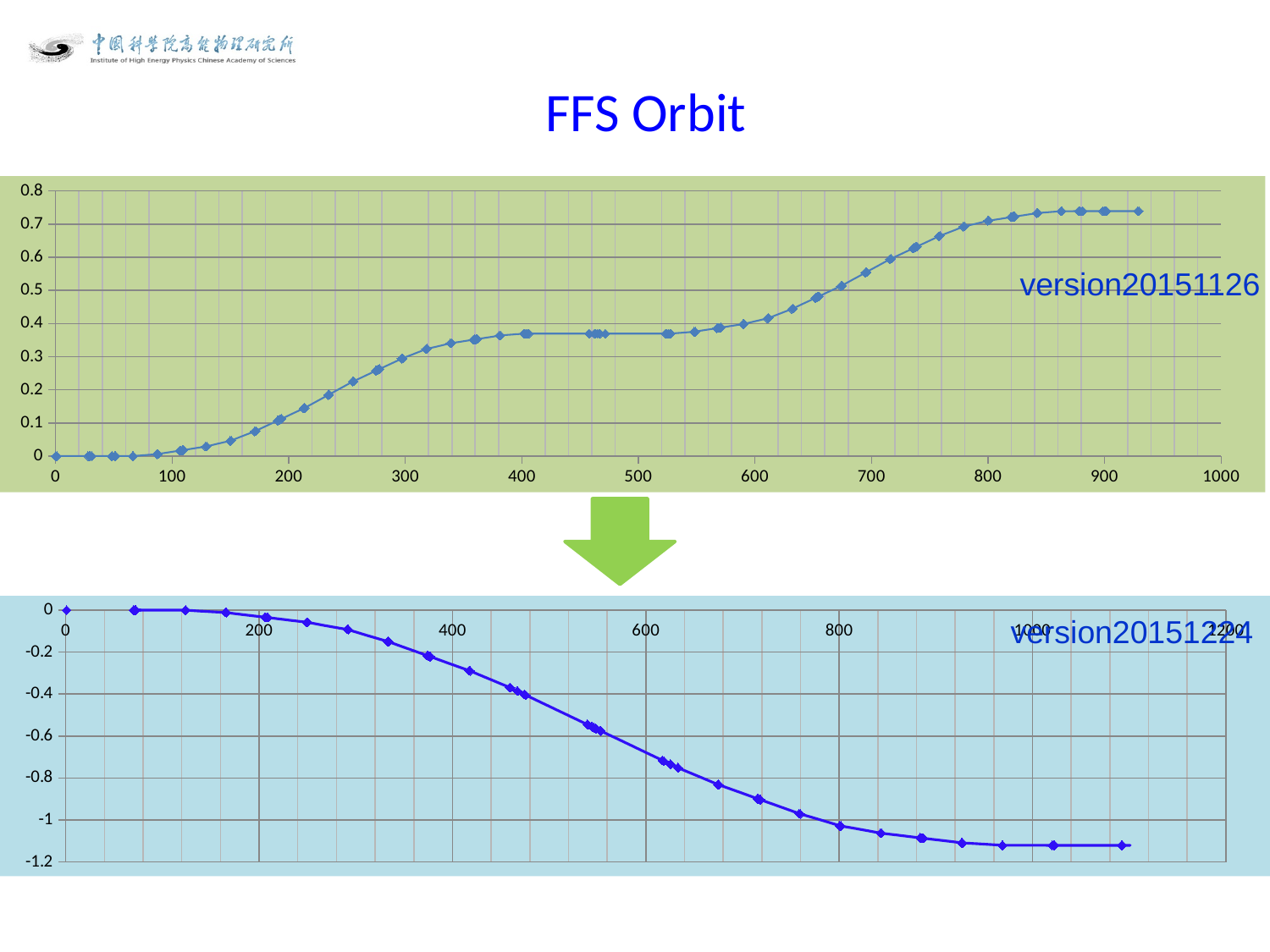
What kind of chart is the top chart (version20151126)? line chart In the top chart (version20151126), which is larger: the value at x = 0 or the value at x = 900? the value at x = 900 In the bottom chart (version20151224), is the value at x = 1000 greater or less than -1? less In the bottom chart (version20151224), which is larger: the value at x = 0 or the value at x = 1000? the value at x = 0 In the top chart (version20151126), is the value at x = 100 greater or less than 0.1? less In the bottom chart (version20151224), is the value at x = 200 greater or less than -0.2? greater In the bottom chart (version20151224), do the values rise or fall as x increases from 0 to 1000? fall What kind of chart is the bottom chart (version20151224)? line chart In the top chart (version20151126), do the values rise or fall as x increases from 0 to 900? rise What is the title of the slide containing the two charts? FFS Orbit